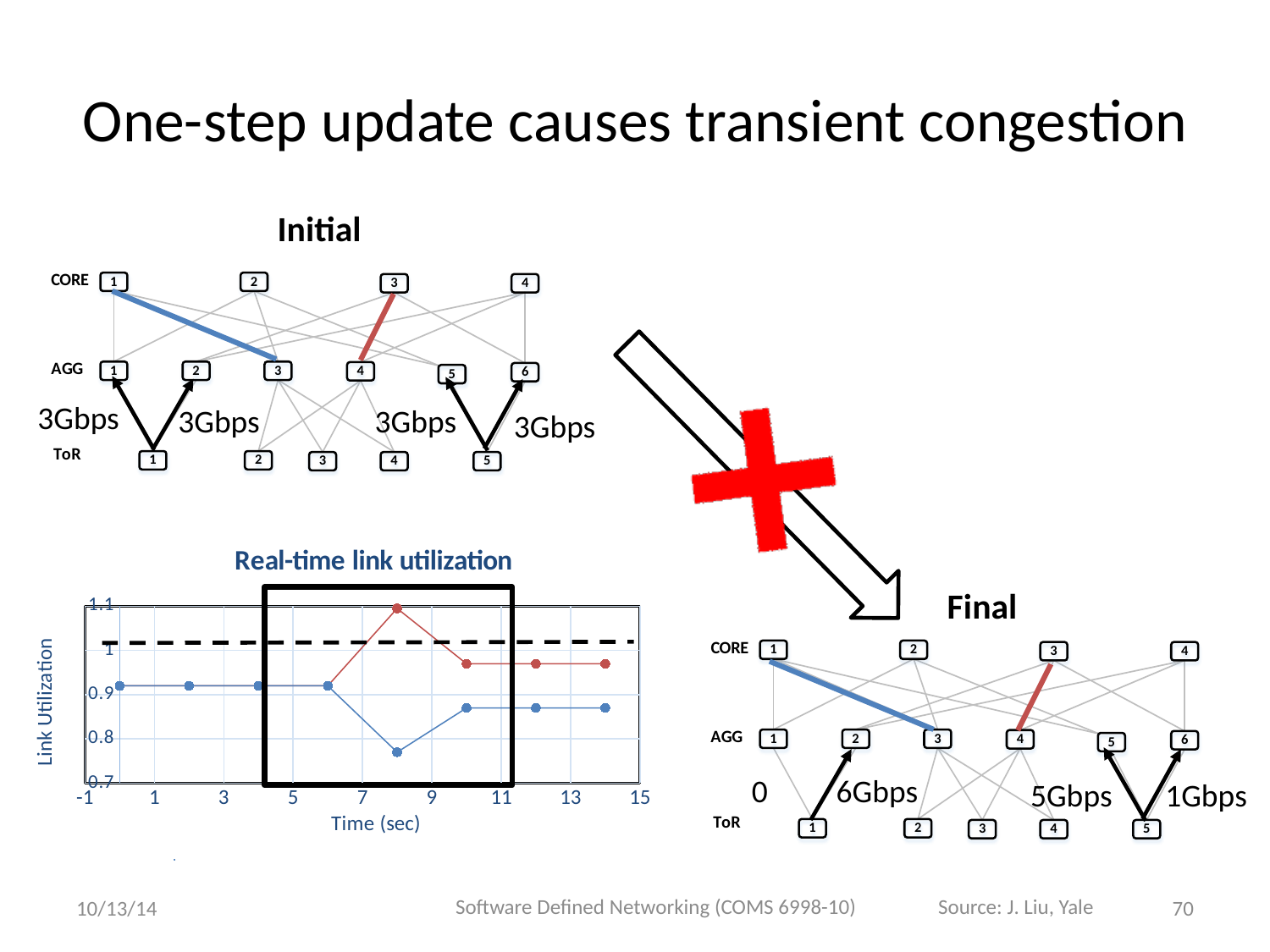
What kind of chart is the "Real-time link utilization" chart? line chart In the "Real-time link utilization" chart, is the red line's value at time 8 greater or less than 1? greater In the "Real-time link utilization" chart, is the blue line's value at time 8 greater or less than 0.8? less In the "Real-time link utilization" chart, is the blue line's value at time 0 greater or less than 0.9? greater In the "Real-time link utilization" chart, at what time (sec) does the red line reach its highest value? 8 In the "Real-time link utilization" chart, does the blue line rise or fall between time 6 and time 8? fall In the "Real-time link utilization" chart, at what time (sec) does the blue line reach its lowest value? 8 How many data points does each line in the "Real-time link utilization" chart have? 8 How many lines (series) are plotted in the "Real-time link utilization" chart? 2 What is the title of the chart on the slide? Real-time link utilization In the "Real-time link utilization" chart, which line has the higher value at time 8, the red line or the blue line? red line What is the x-axis title of the "Real-time link utilization" chart? Time (sec)